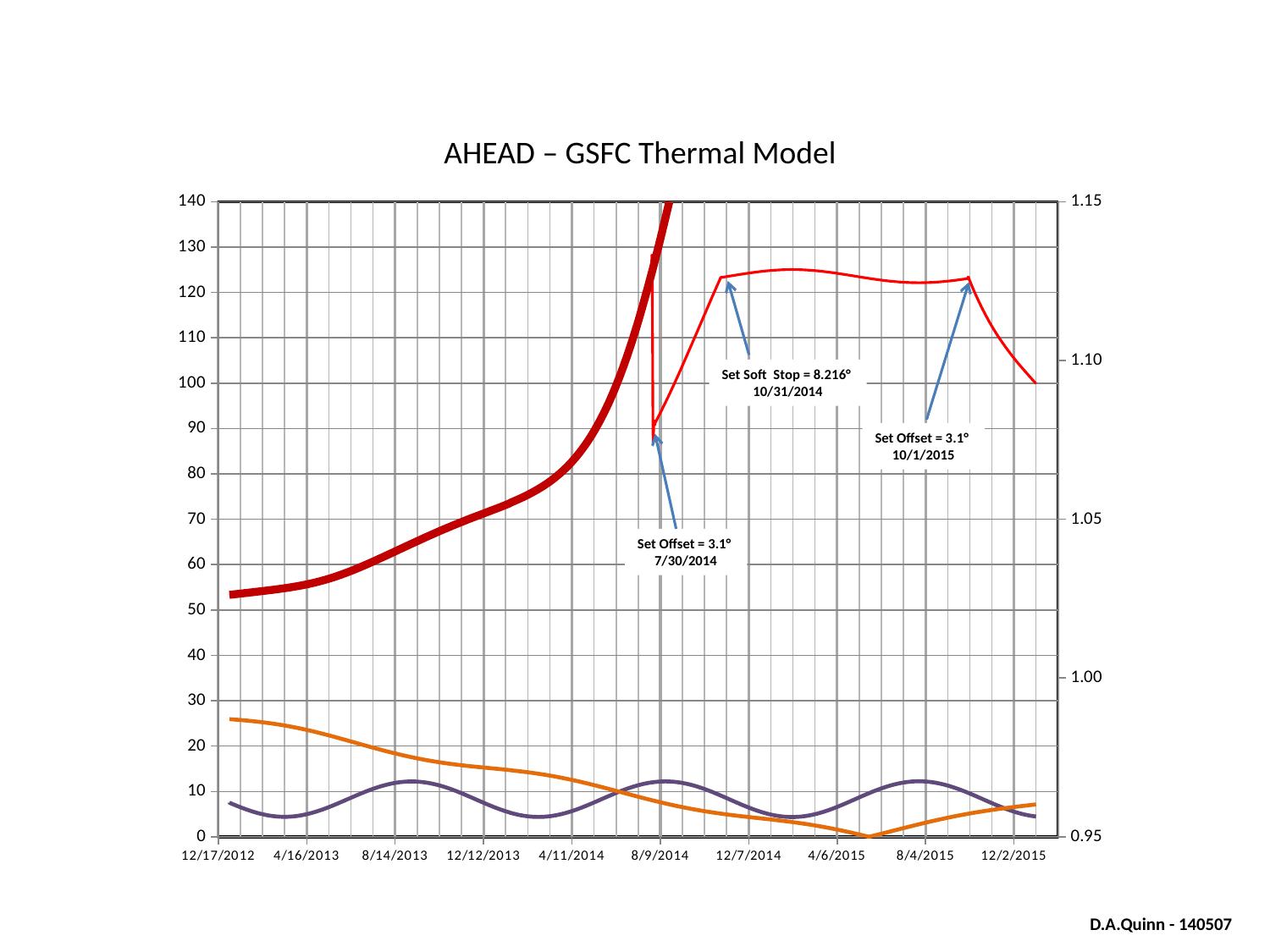
On the left axis, is the highest point of the purple line greater or less than 20? less How many annotation callouts with arrows are placed on the chart? 3 On the left axis, is the value of the thick dark red line at 12/17/2012 greater or less than 60? less On the left axis, is the value of the thin red line at 12/7/2014 greater or less than 120? greater Does the thick dark red line rise or fall as the dates move from 12/17/2012 toward 8/9/2014? rise What is the title of the chart? AHEAD – GSFC Thermal Model According to the annotation, on what date was the Soft Stop set to 8.216°? 10/31/2014 What kind of chart is shown on the slide? line chart Does the orange line rise or fall from 12/17/2012 to 4/6/2015? fall At 12/17/2012, which line has the larger value on the left axis, the orange line or the purple line? orange line